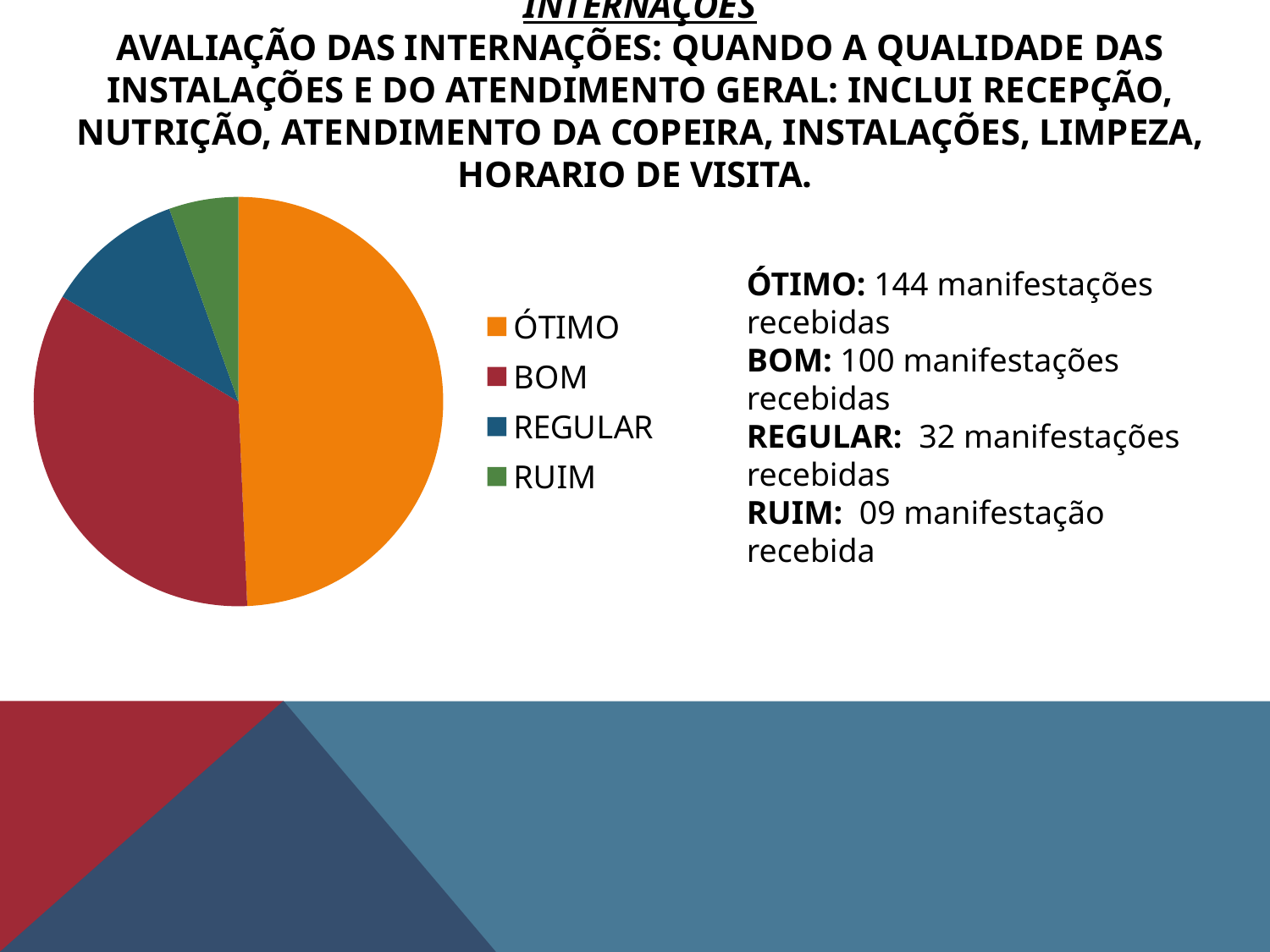
How many manifestações were received for RUIM? 09 Which has more manifestações, REGULAR or RUIM? REGULAR Which category is listed third in the legend? REGULAR What kind of chart is shown on the slide? pie chart What colour is the slice for BOM in the pie chart? red Which category has the largest slice of the pie chart? ÓTIMO How many categories does the pie chart have? 4 How many manifestações were received for ÓTIMO? 144 What is the difference between the number of manifestações for ÓTIMO and BOM? 44 Which category has the smallest slice of the pie chart? RUIM How many manifestações were received for REGULAR? 32 How many manifestações were received for BOM? 100